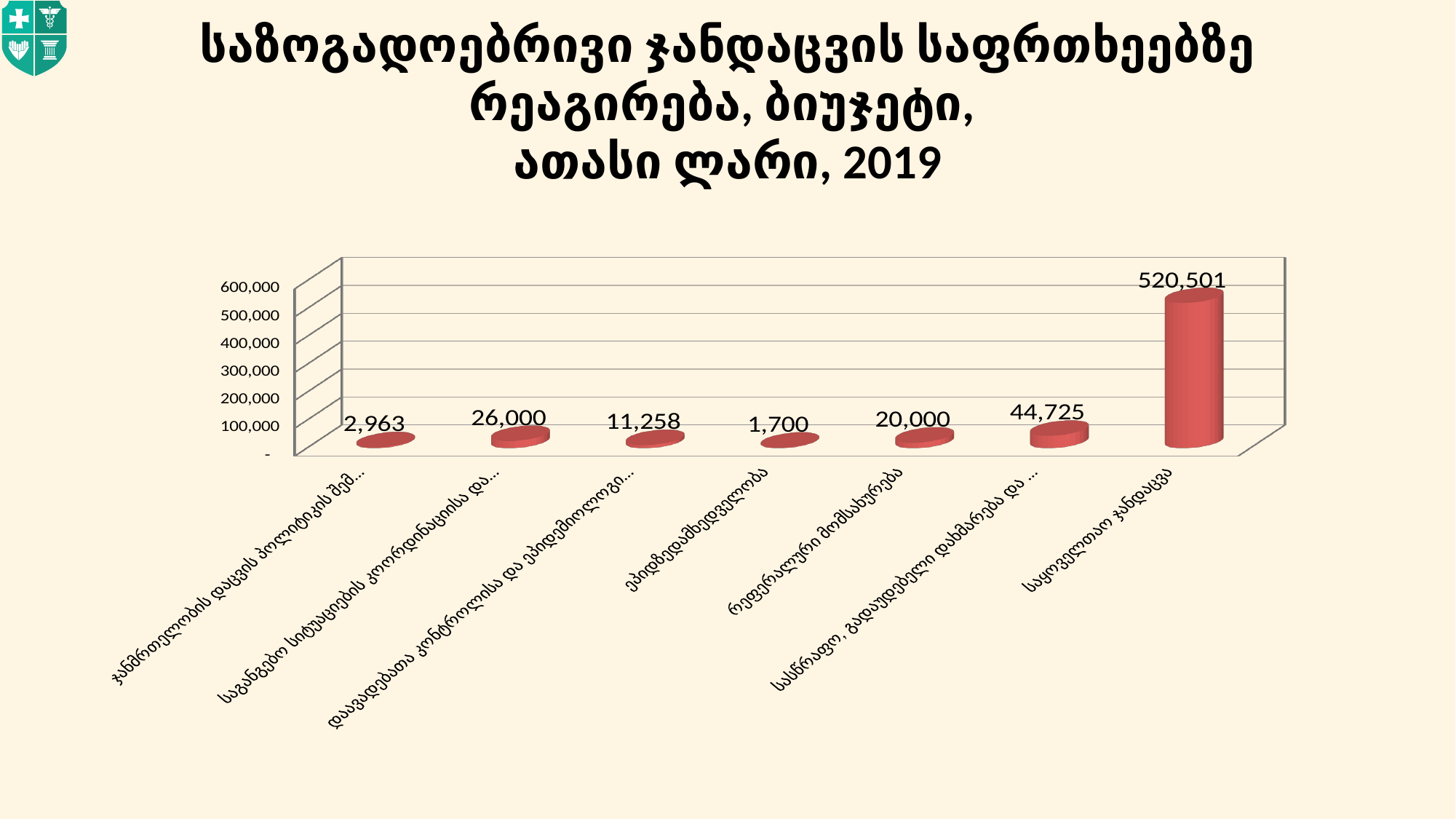
Which is larger, the value for რეფერალური მომსახურება or the value for ეპიდზედამხედველობა? რეფერალური მომსახურება What kind of chart is shown on the slide? bar chart Which category has the lowest value? ეპიდზედამხედველობა What is the value for ეპიდზედამხედველობა? 1,700 Which year is stated in the chart title? 2019 What is the value for რეფერალური მომსახურება? 20,000 What is the value shown on the sixth bar from the left (სასწრაფო, გადაუდებელი დახმარება...)? 44,725 What is the difference between the values for რეფერალური მომსახურება and ეპიდზედამხედველობა? 18,300 What is the value for საყოველთაო ჯანდაცვა? 520,501 Which category has the highest value? საყოველთაო ჯანდაცვა How many categories are shown in the chart? 7 Is the value for საყოველთაო ჯანდაცვა greater or less than 500,000? greater